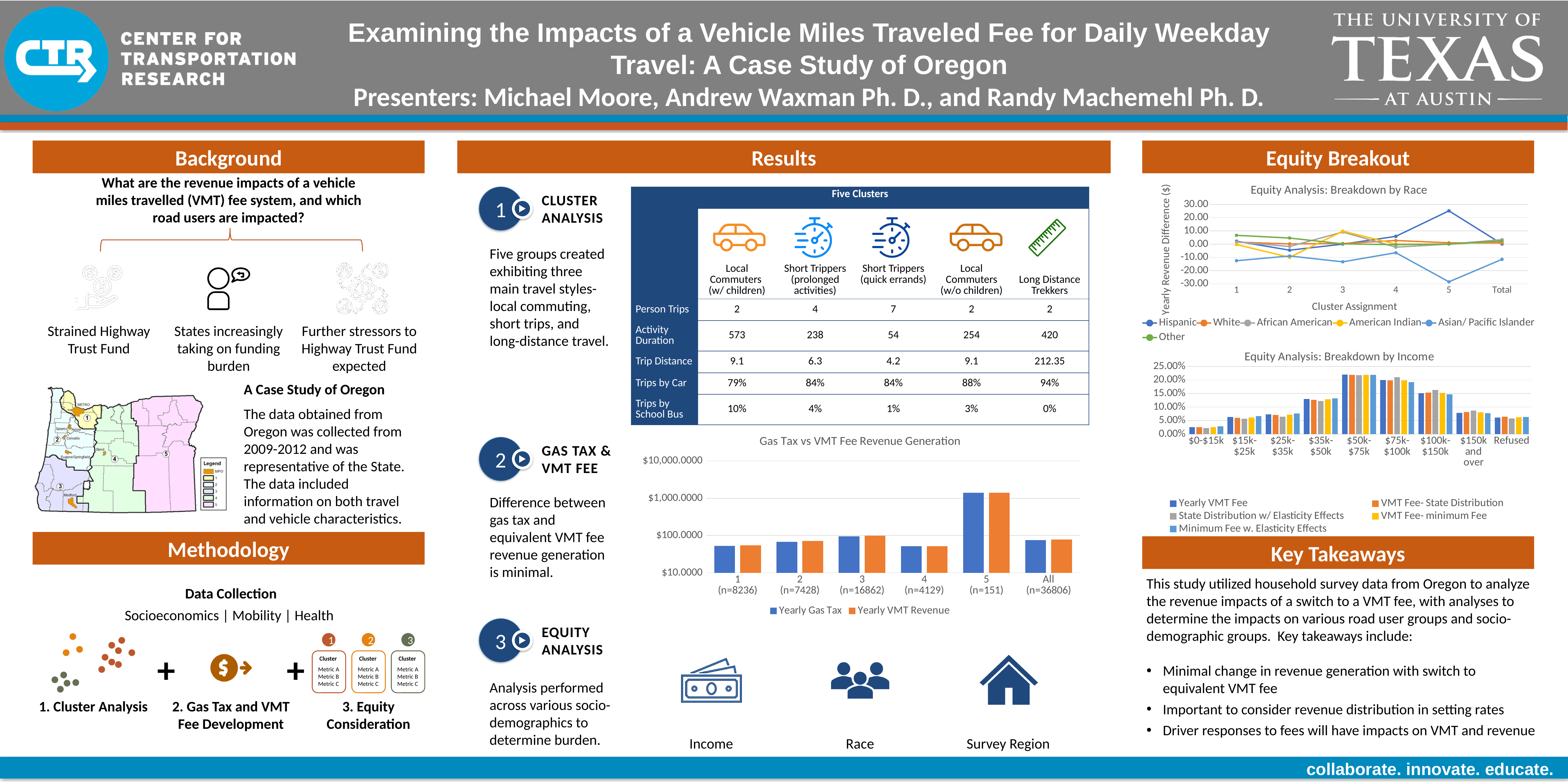
What kind of chart is "Gas Tax vs VMT Fee Revenue Generation"? bar chart In "Equity Analysis: Breakdown by Race", which series reaches the highest value at cluster 5? Hispanic How many income categories are shown on the x axis of "Equity Analysis: Breakdown by Income"? 9 In "Gas Tax vs VMT Fee Revenue Generation", is the Yearly VMT Revenue for cluster 5 (n=151) greater or less than $1,000.0000? greater How many series does the legend of "Equity Analysis: Breakdown by Race" list? 6 How many series does the legend of "Gas Tax vs VMT Fee Revenue Generation" list? 2 What kind of chart is "Equity Analysis: Breakdown by Race"? line chart What is the y-axis label of "Equity Analysis: Breakdown by Race"? Yearly Revenue Difference ($) In "Gas Tax vs VMT Fee Revenue Generation", is the Yearly Gas Tax for cluster 1 (n=8236) greater or less than $100.0000? less How many categories are shown on the x axis of "Gas Tax vs VMT Fee Revenue Generation"? 6 In "Gas Tax vs VMT Fee Revenue Generation", which cluster has the highest Yearly Gas Tax? 5 (n=151) In "Equity Analysis: Breakdown by Income", which income category has the highest Yearly VMT Fee share? $50k-$75k